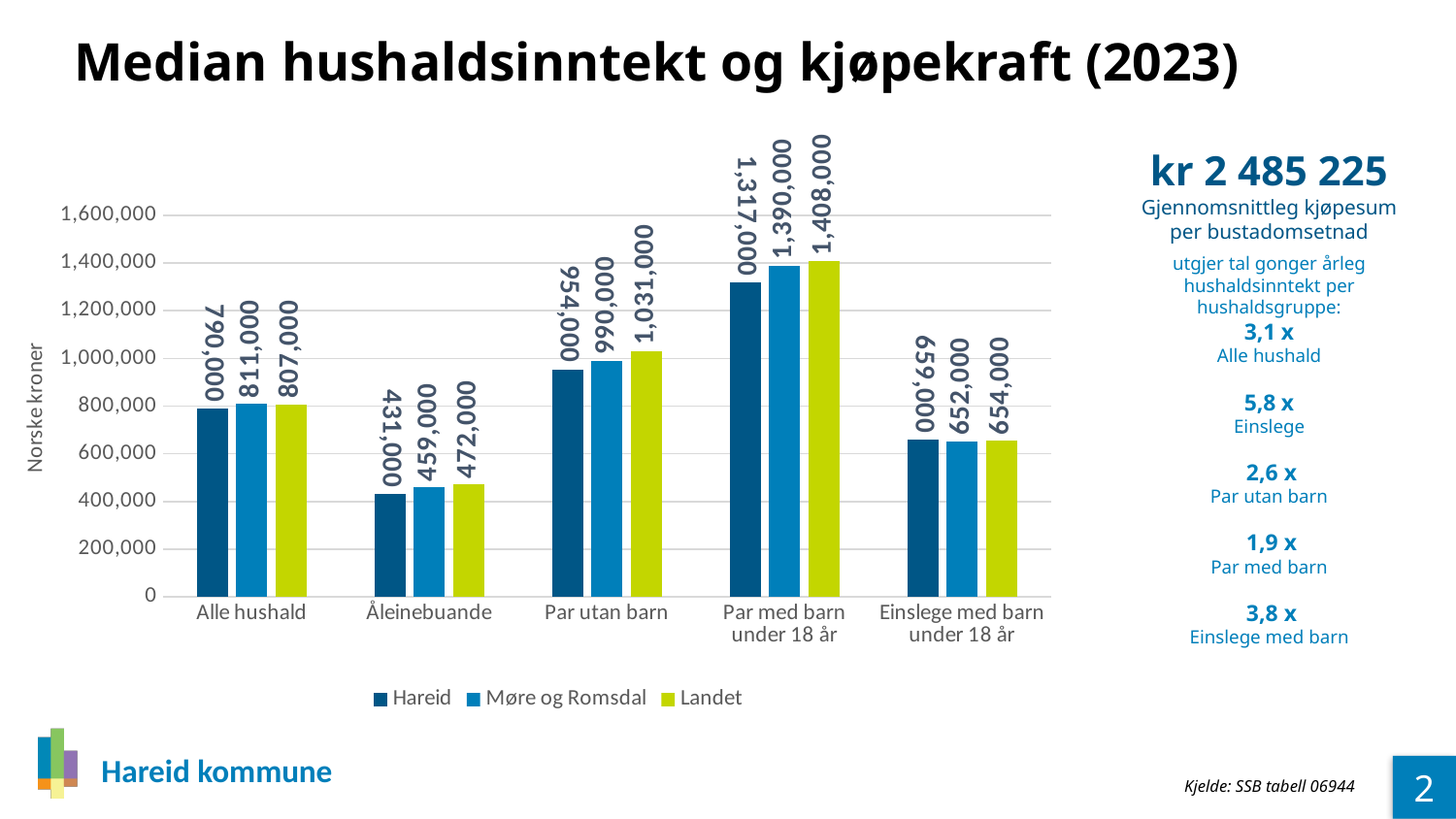
How many categories are shown on the x axis? 5 In the Einslege med barn under 18 år category, which is larger: Hareid or Møre og Romsdal? Hareid What is the value for Hareid in the Alle hushald category? 790,000 Is the value for Møre og Romsdal in the Par utan barn category greater or less than 1,000,000? less What is the difference between the Landet and Hareid values in the Par utan barn category? 77,000 What is the label of the y axis? Norske kroner Which category has the lowest value for Landet? Åleinebuande Which category has the highest value for Hareid? Par med barn under 18 år How many series does the legend list? 3 What kind of chart is shown on the slide? Bar chart What is the value for Møre og Romsdal in the Åleinebuande category? 459,000 What is the value for Landet in the Par med barn under 18 år category? 1,408,000